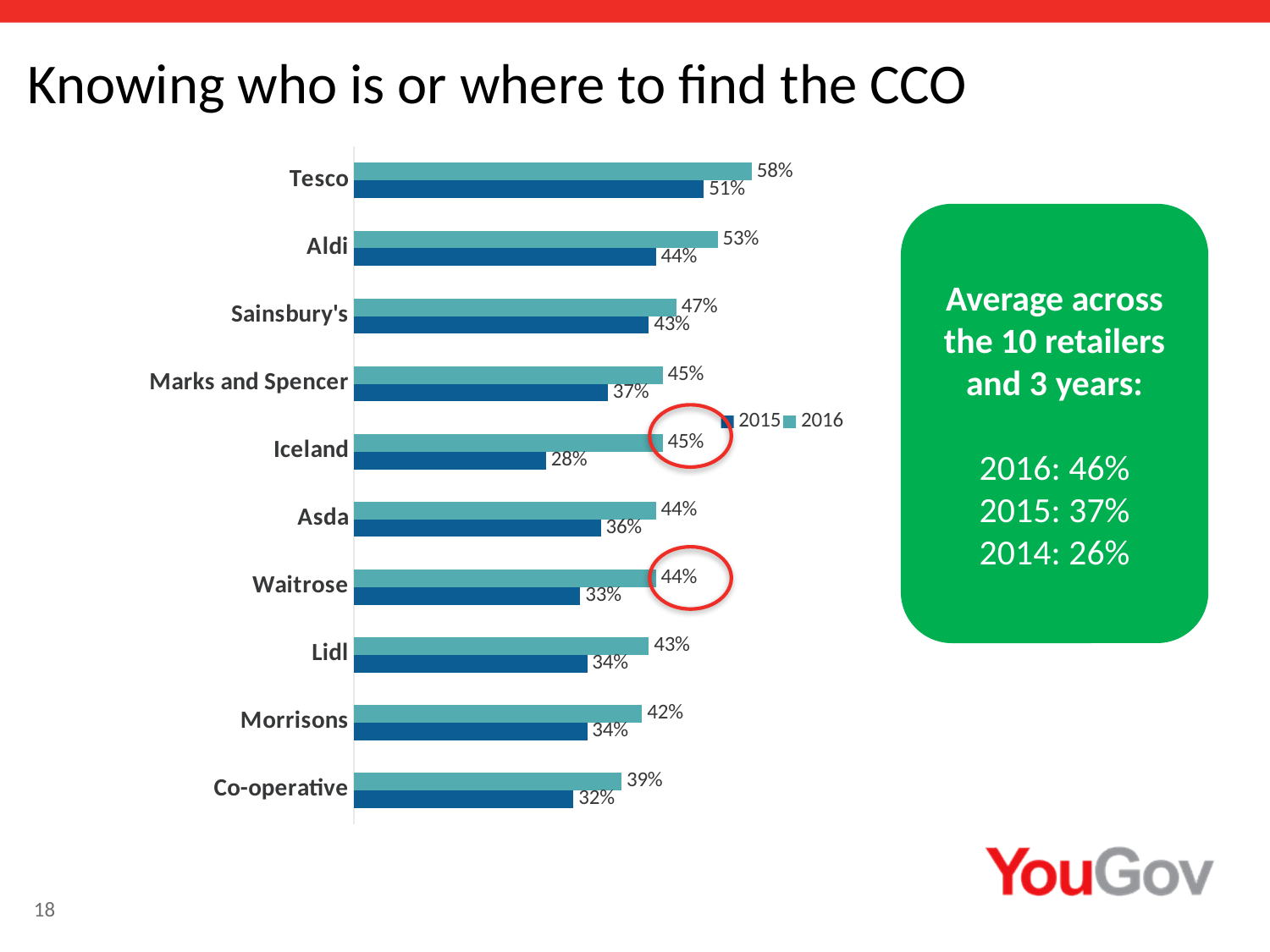
Which is larger, the 2015 value for Aldi or the 2015 value for Sainsbury's? Aldi What kind of chart is shown on the slide? Bar chart What is the difference between the 2016 and 2015 values for Iceland? 17 percentage points What is the 2015 value for Iceland? 28% What is the 2016 value for Waitrose? 44% Which retailer has the highest 2016 value? Tesco What is the 2016 value for Tesco? 58% Which two retailers have their 2016 bars circled in red? Iceland and Waitrose How many retailers are shown in the chart? 10 What is the difference between the 2016 values for Tesco and Co-operative? 19 percentage points Which retailer has the lowest 2015 value? Iceland How many series does the legend list? 2